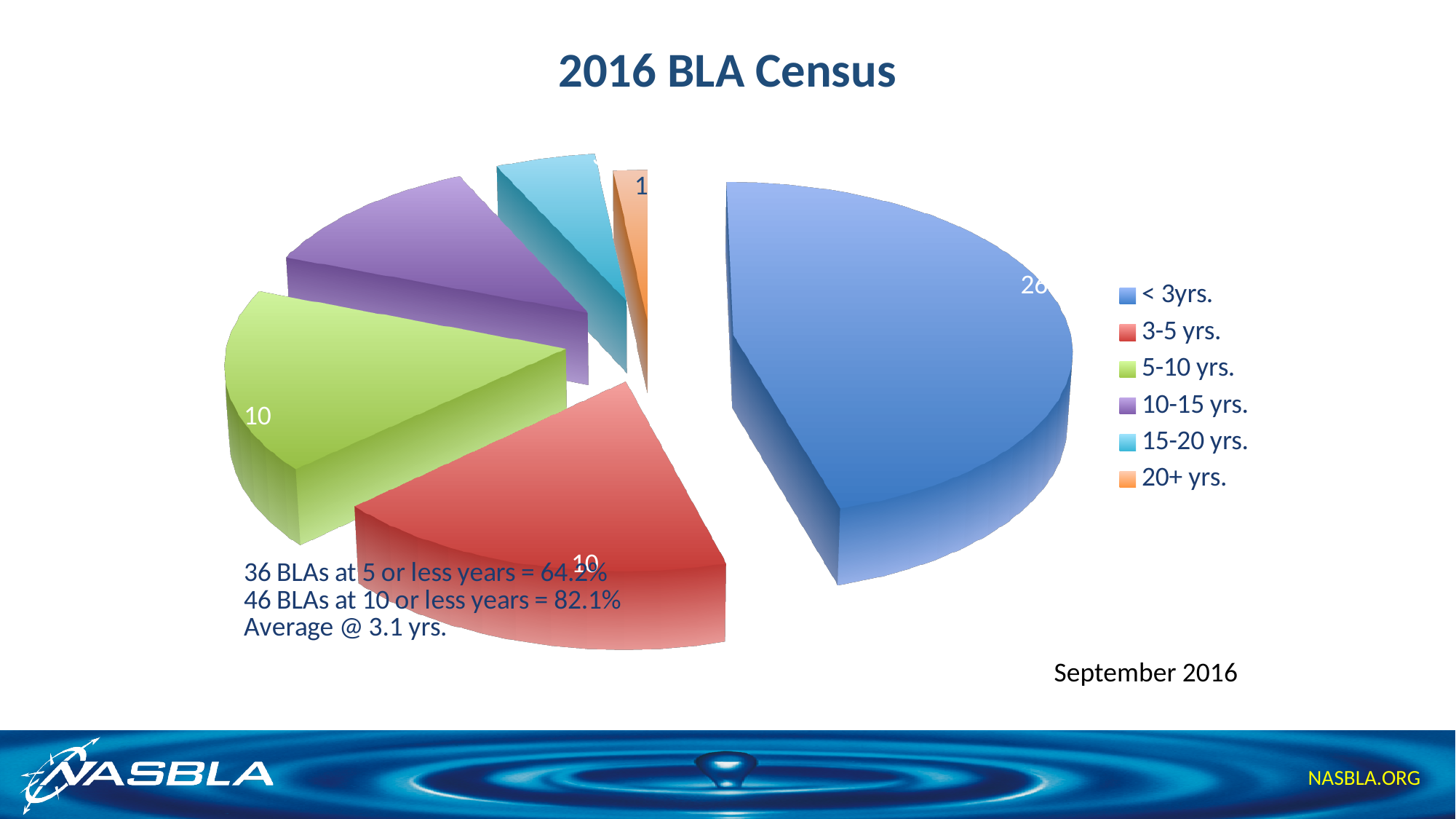
Which slice is larger, 10-15 yrs. or 15-20 yrs.? 10-15 yrs. What colour is the < 3yrs. slice? blue What is the value shown for the 20+ yrs. slice? 1 Which category has the largest slice of the pie? < 3yrs. Which category has the smallest slice of the pie? 20+ yrs. What is the title of the chart? 2016 BLA Census What is the difference between the 5-10 yrs. value and the 20+ yrs. value? 9 Which slice is larger, < 3yrs. or 5-10 yrs.? < 3yrs. What kind of chart is shown on the slide? pie chart What is the value shown for the 3-5 yrs. slice? 10 What is the value shown for the 5-10 yrs. slice? 10 How many categories does the legend list? 6